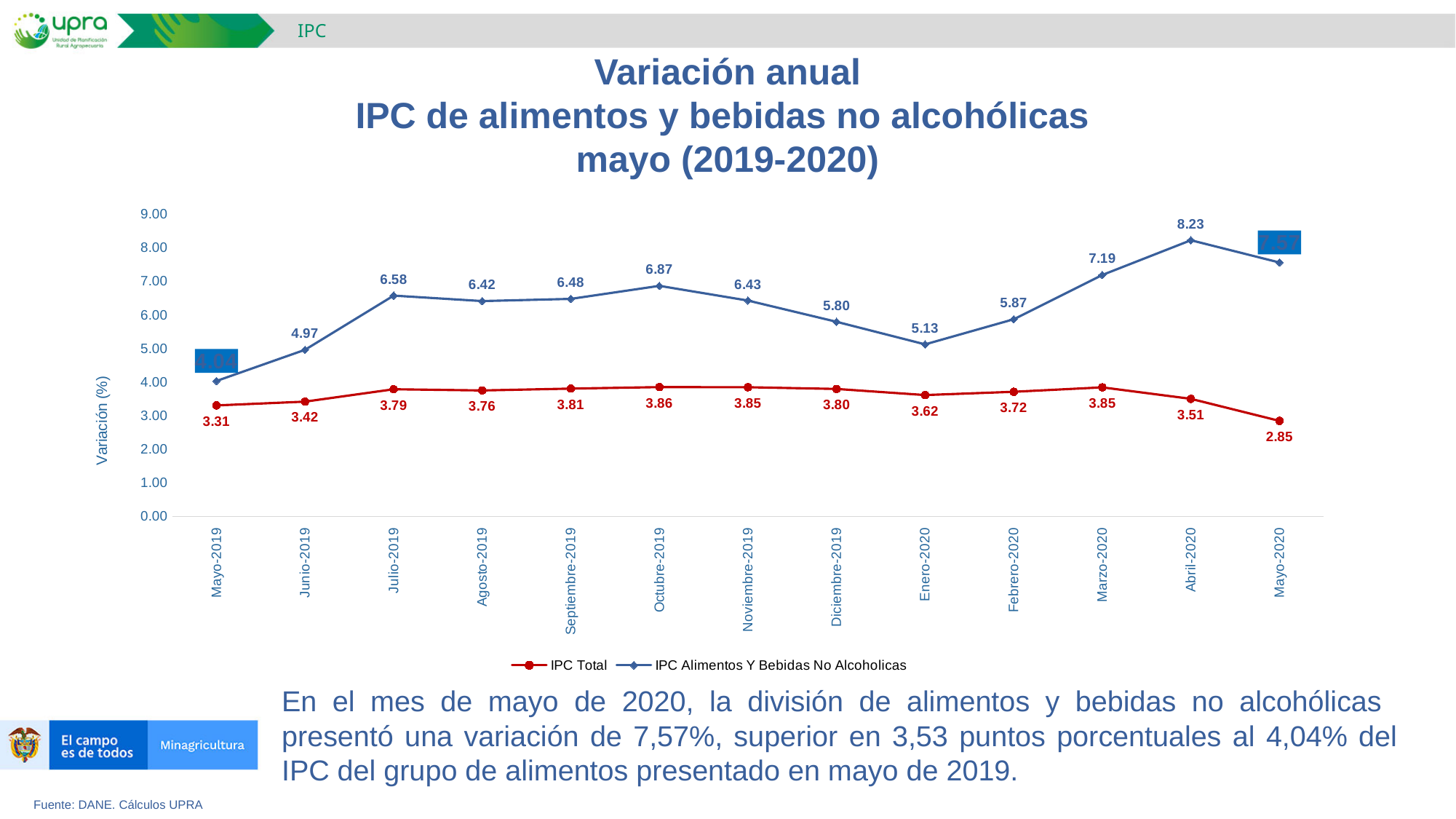
What colour is the line for IPC Total? Red What is the value of IPC Total for Mayo-2020? 2.85 What is the difference between IPC Alimentos Y Bebidas No Alcoholicas and IPC Total in Abril-2020? 4.72 Which series has the higher value in Octubre-2019, IPC Total or IPC Alimentos Y Bebidas No Alcoholicas? IPC Alimentos Y Bebidas No Alcoholicas What type of chart is shown on the slide? Line chart Does IPC Total rise or fall from Marzo-2020 to Mayo-2020? Fall What is the value of IPC Alimentos Y Bebidas No Alcoholicas for Abril-2020? 8.23 What is the value of IPC Alimentos Y Bebidas No Alcoholicas for Enero-2020? 5.13 How many months are plotted along the x axis? 13 In which month does IPC Alimentos Y Bebidas No Alcoholicas reach its highest value? Abril-2020 In which month is IPC Total at its lowest value? Mayo-2020 How many series does the legend list? 2